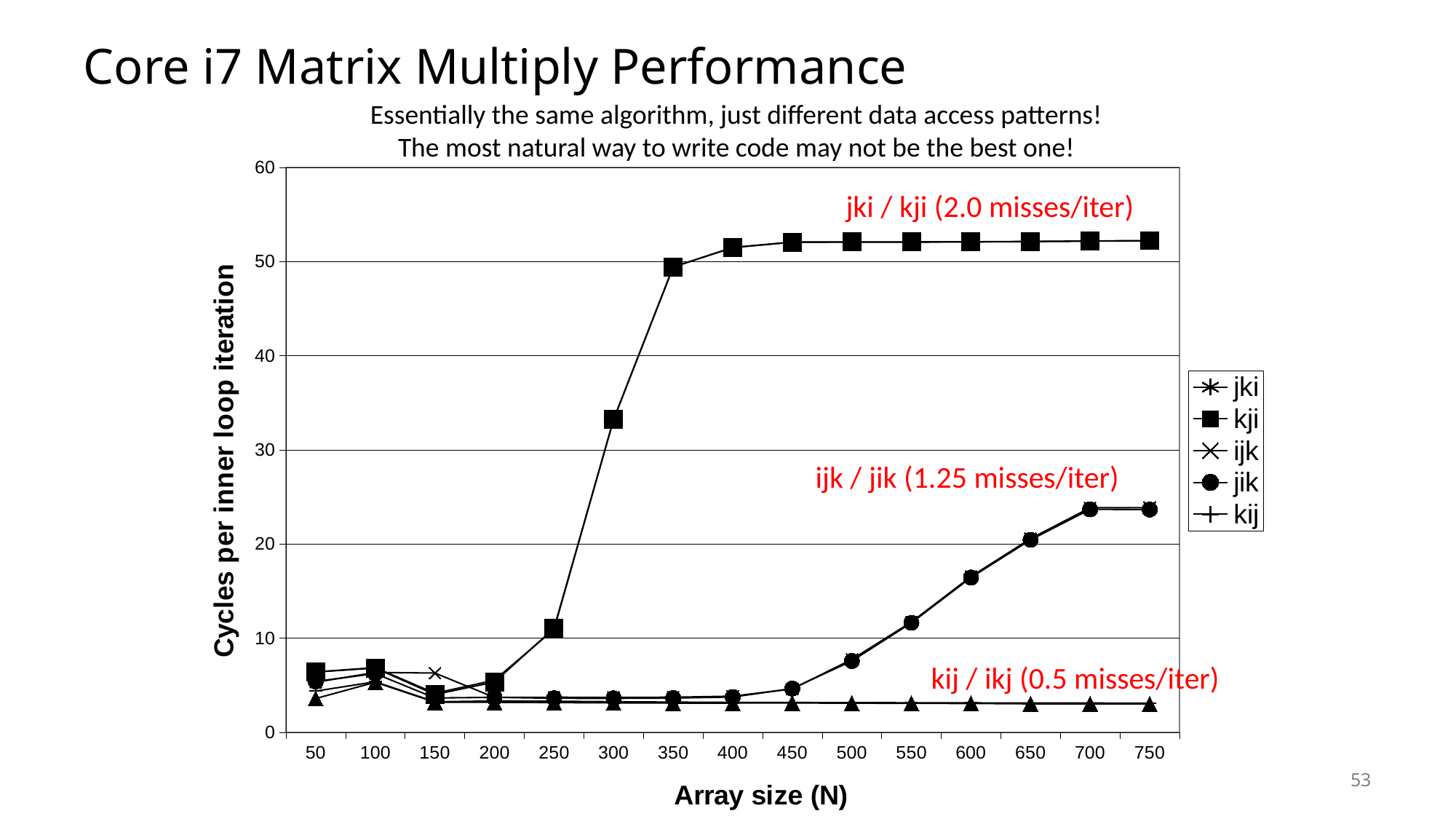
At N = 750, which is larger: the value for kji or the value for jik? kji Which series has the highest cycles per inner loop iteration at N = 750? kji (jki / kji) How many series does the legend list? 5 Is the value for jik at N = 600 greater or less than 20? less Does the kji series rise or fall as the array size increases from 200 to 450? rise Is the value for jik at N = 750 greater or less than 20? greater Is the value for kij at N = 750 greater or less than 10? less How many array sizes (N) are plotted along the x axis? 15 What is the label of the y axis? Cycles per inner loop iteration What kind of chart is shown on the slide? line chart